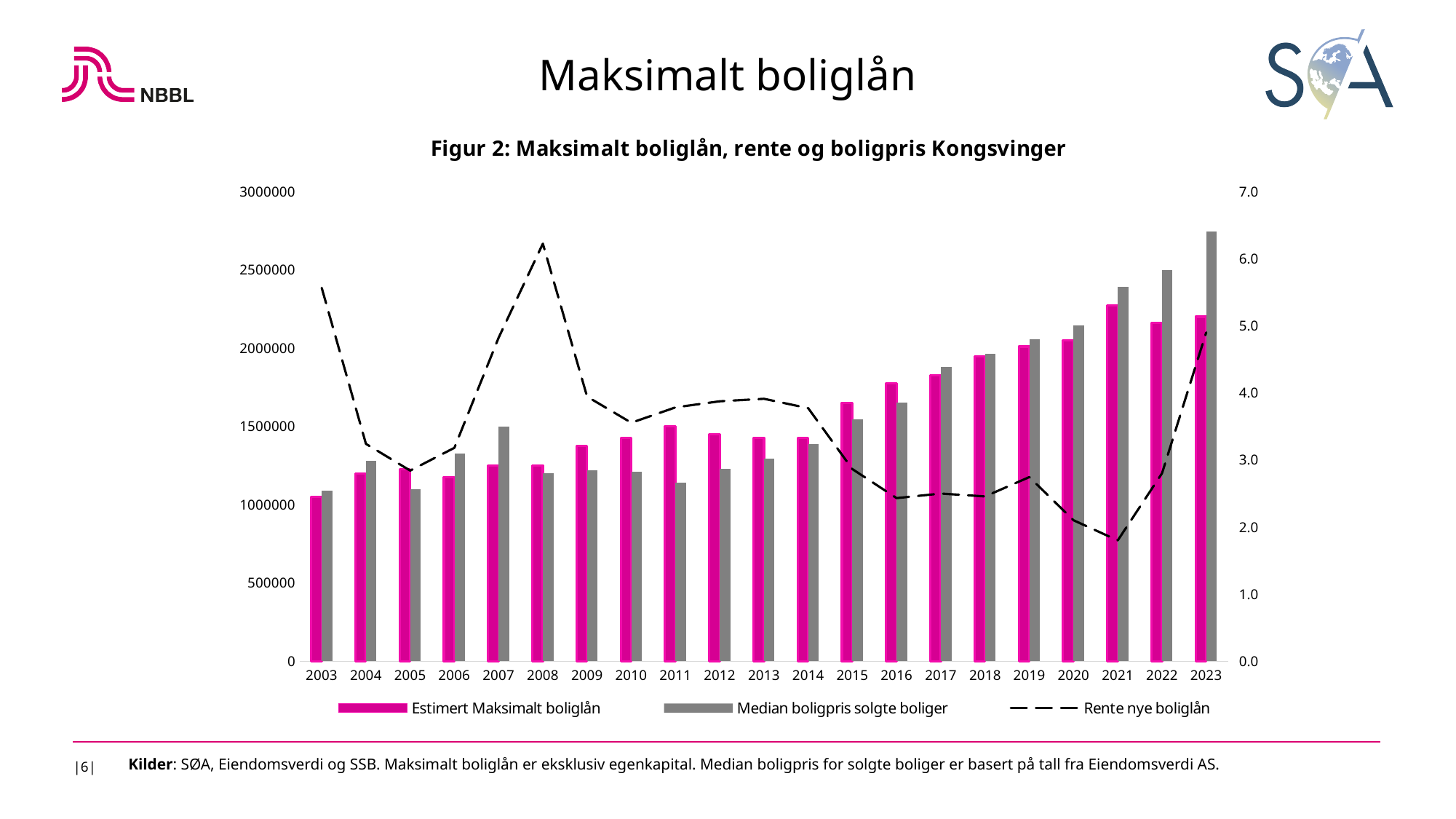
In which year does Rente nye boliglån reach its highest value? 2008 In which year is Median boligpris solgte boliger highest? 2023 How many years are shown on the x axis of Figur 2? 21 What kind of chart is shown in Figur 2? Bar chart with a dashed line series In which year is Estimert Maksimalt boliglån highest? 2021 In which year is Estimert Maksimalt boliglån lowest? 2003 In 2007, which is larger: Estimert Maksimalt boliglån or Median boligpris solgte boliger? Median boligpris solgte boliger How many series does the legend of Figur 2 list? 3 Is the value of Median boligpris solgte boliger in 2023 greater or less than 2500000? greater Does Median boligpris solgte boliger rise or fall from 2015 to 2023? Rise In which year does Rente nye boliglån reach its lowest value? 2021 Is the value of Rente nye boliglån in 2021 greater or less than 2.0? less